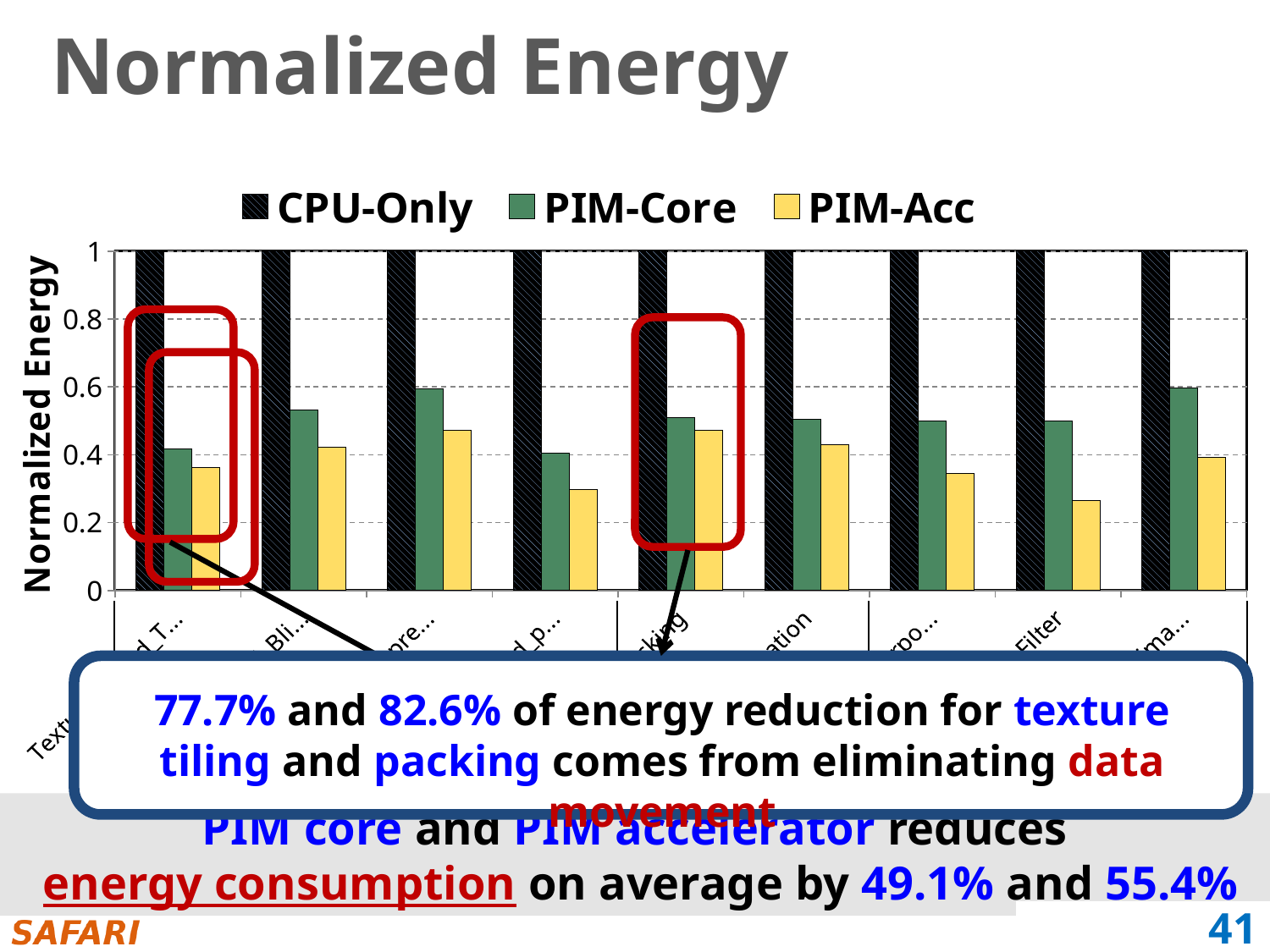
Is the PIM-Core value for Filter greater or less than 0.4? greater How many series does the legend list? 3 What is the label of the y axis? Normalized Energy What is the normalized energy value of the CPU-Only series for the Filter category? 1 Which series are listed in the legend? CPU-Only, PIM-Core, PIM-Acc For the Filter category, which is larger: the PIM-Core value or the PIM-Acc value? PIM-Core Is the PIM-Acc value for Filter greater or less than 0.2? greater Which series has the lowest bar for the Filter category? PIM-Acc How many groups of bars (categories) are plotted? 9 What kind of chart is shown on the slide? bar chart Which series has the highest bar in every category? CPU-Only Is the PIM-Acc value for Filter greater or less than 0.4? less